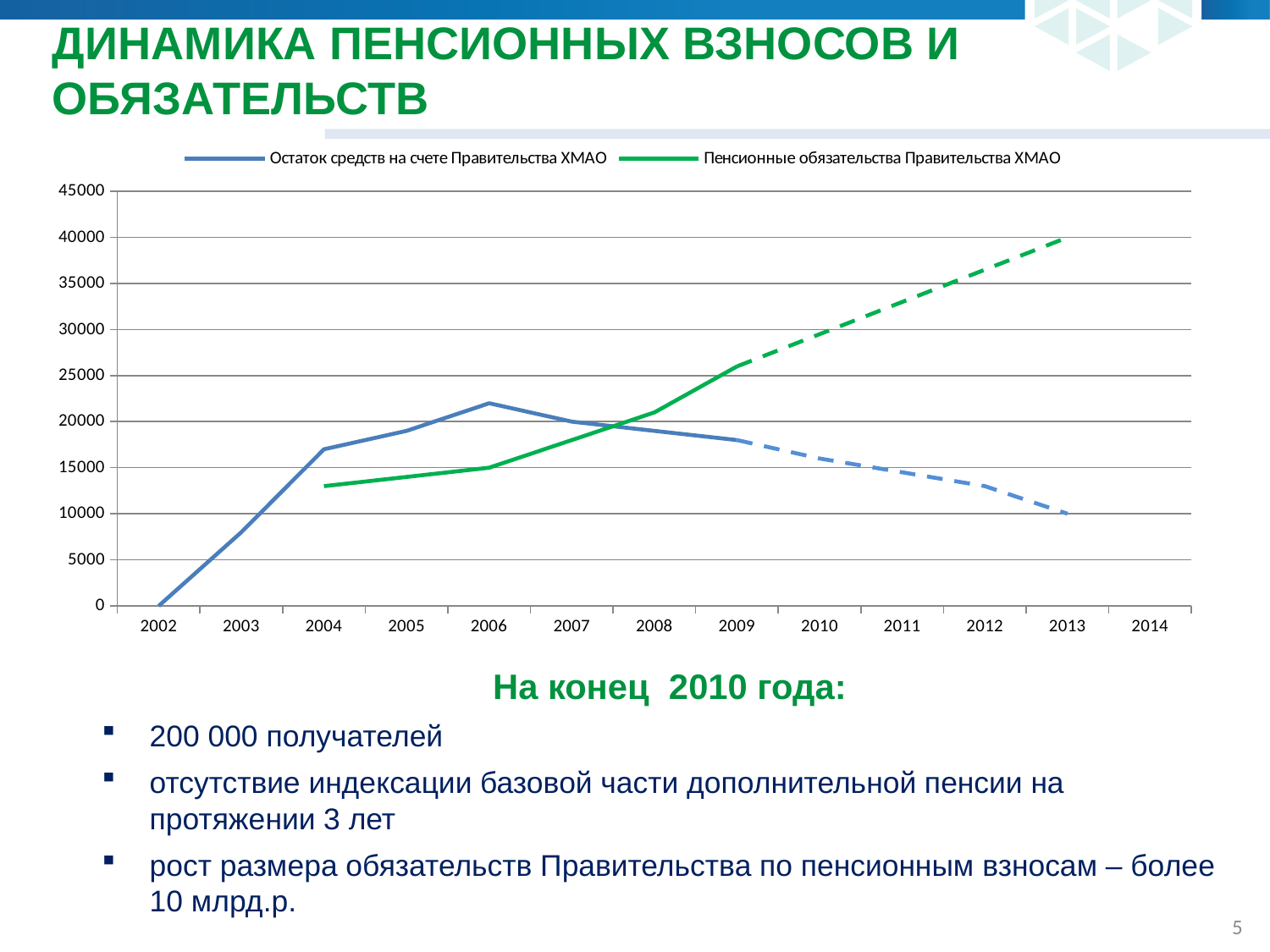
What colour is the line for Пенсионные обязательства Правительства ХМАО? green How many series does the legend list? 2 In which year is Пенсионные обязательства Правительства ХМАО highest? 2013 Is the value for Пенсионные обязательства Правительства ХМАО in 2012 greater or less than 35000? greater How many years are labelled on the x axis? 13 In 2009, which series has the larger value: Остаток средств на счете Правительства ХМАО or Пенсионные обязательства Правительства ХМАО? Пенсионные обязательства Правительства ХМАО Is the value for Остаток средств на счете Правительства ХМАО in 2006 greater or less than 20000? greater Does Пенсионные обязательства Правительства ХМАО rise or fall from 2004 to 2013? rise In which year does Остаток средств на счете Правительства ХМАО reach its highest value? 2006 What is the value of Остаток средств на счете Правительства ХМАО in 2002? 0 Is the value for Пенсионные обязательства Правительства ХМАО in 2004 greater or less than 15000? less What kind of chart is shown on the slide? line chart